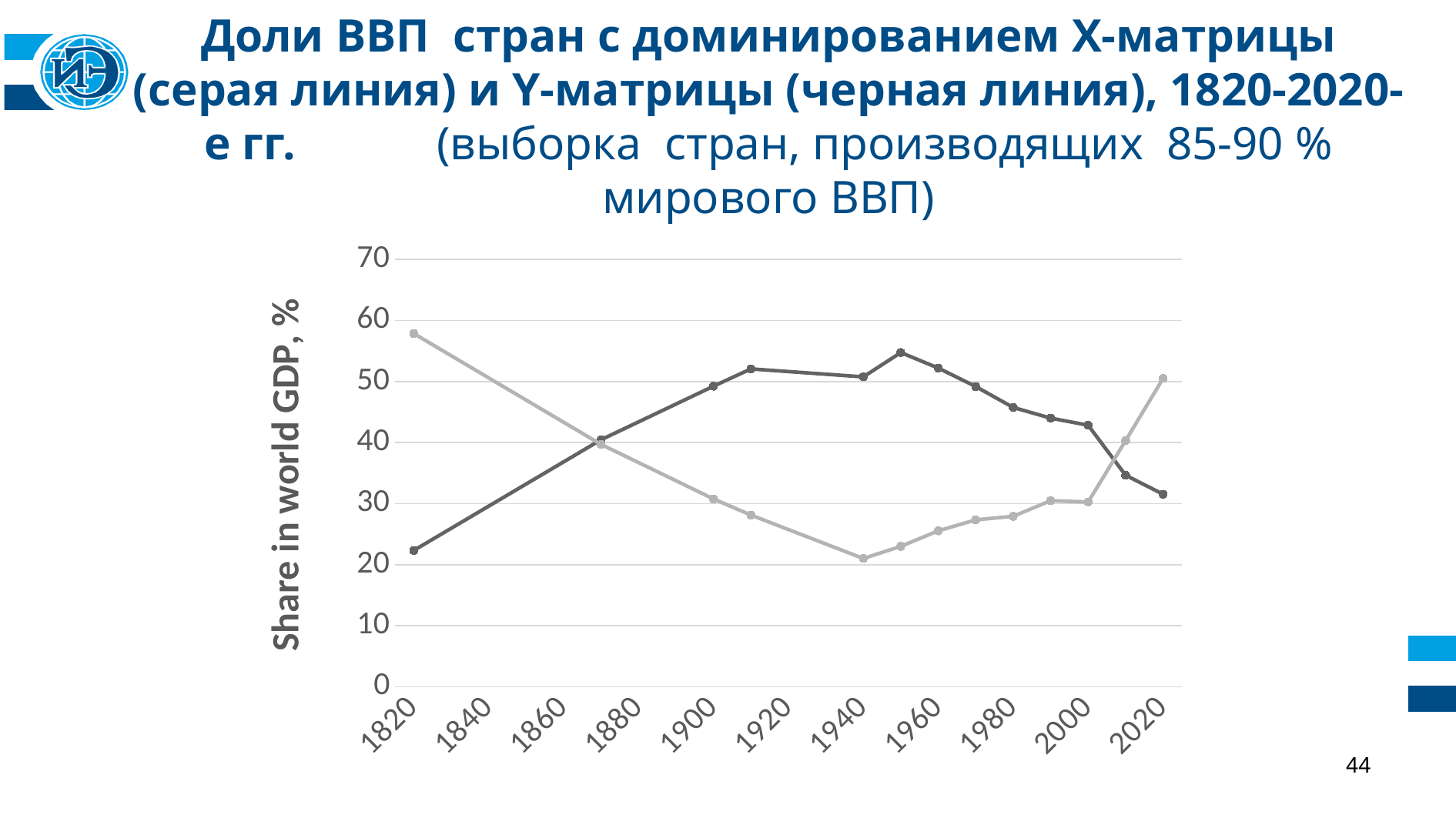
In 1820, which line is higher: the grey line (X-matrix) or the black line (Y-matrix)? grey line (X-matrix) What is the label of the vertical axis of the chart? Share in world GDP, % Does the black line (Y-matrix) rise or fall between 1820 and 1900? rise Is the value of the grey line (X-matrix) in 1940 greater or less than 30? less Does the black line (Y-matrix) rise or fall between 1950 and 2020? fall In 2020, which line is higher: the grey line (X-matrix) or the black line (Y-matrix)? grey line (X-matrix) What kind of chart is shown on the slide? line chart Is the value of the black line (Y-matrix) in 1950 greater or less than 50? greater Is the value of the black line (Y-matrix) in 2020 greater or less than 40? less Does the grey line (X-matrix) rise or fall between 1820 and 1940? fall